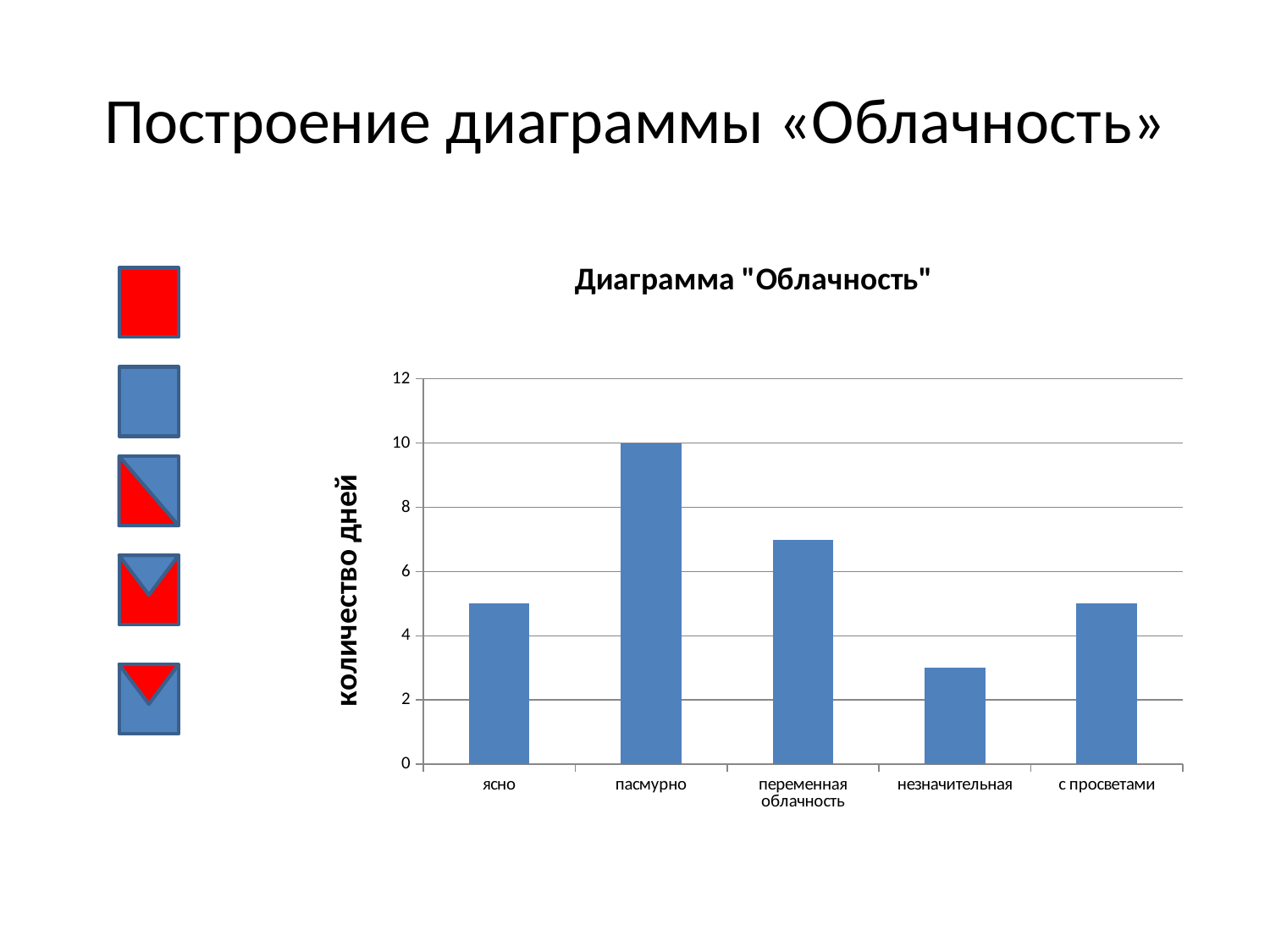
How many categories are shown on the x axis? 5 Which is larger, the value for пасмурно or the value for ясно? пасмурно Is the value for незначительная greater or less than 4? less Is the value for ясно greater or less than 4? greater What type of chart is shown on the slide? bar chart Which category has the highest value? пасмурно Is the value for переменная облачность greater or less than 8? less What is the value for пасмурно? 10 Which is larger, the value for переменная облачность or the value for незначительная? переменная облачность What is the title of the chart? Диаграмма "Облачность" Which category has the lowest value? незначительная What is the label of the vertical axis? количество дней